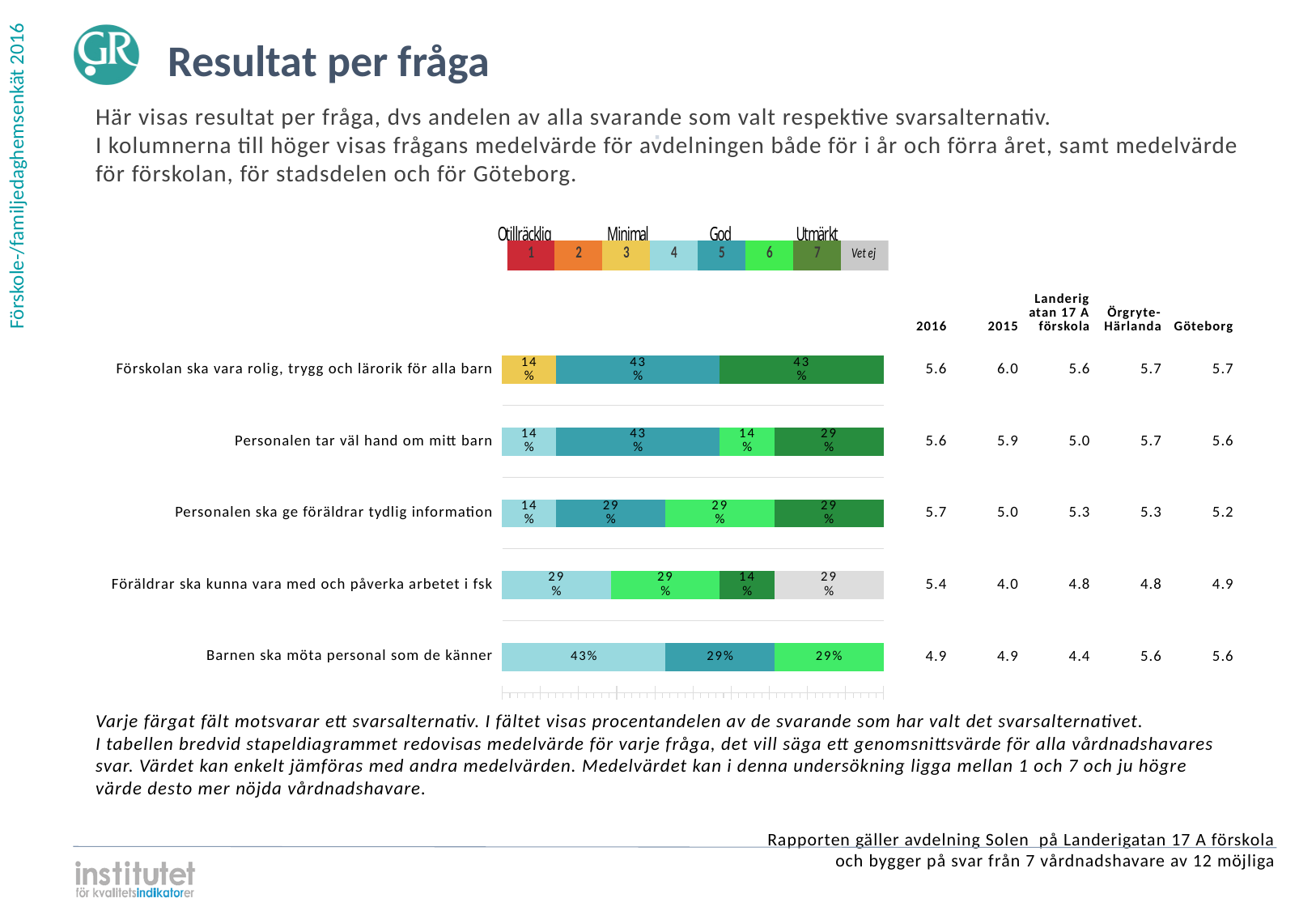
What is the 2015 mean value shown for 'Föräldrar ska kunna vara med och påverka arbetet i fsk'? 4.0 What is the 2016 mean value shown for 'Barnen ska möta personal som de känner'? 4.9 What percentage of respondents chose alternative 4 (light blue) for 'Barnen ska möta personal som de känner'? 43% What percentage of respondents answered 'Vet ej' (grey) for 'Föräldrar ska kunna vara med och påverka arbetet i fsk'? 29% How many response alternatives does the colour legend above the chart list? 8 What percentage of respondents chose alternative 3 (yellow) for 'Förskolan ska vara rolig, trygg och lärorik för alla barn'? 14% How many questions (categories) are shown as bars in the chart? 5 For 'Personalen ska ge föräldrar tydlig information', what is the difference between the share choosing alternative 5 and the share choosing alternative 4? 15% What percentage of respondents chose alternative 5 (teal) for 'Personalen tar väl hand om mitt barn'? 43% What kind of chart is used to show the results per question? Stacked bar chart What percentage of respondents chose alternative 7 (dark green) for 'Förskolan ska vara rolig, trygg och lärorik för alla barn'? 43% For 'Personalen tar väl hand om mitt barn', which is larger: the share choosing alternative 5 (teal) or the share choosing alternative 7 (dark green)? Alternative 5 (teal)